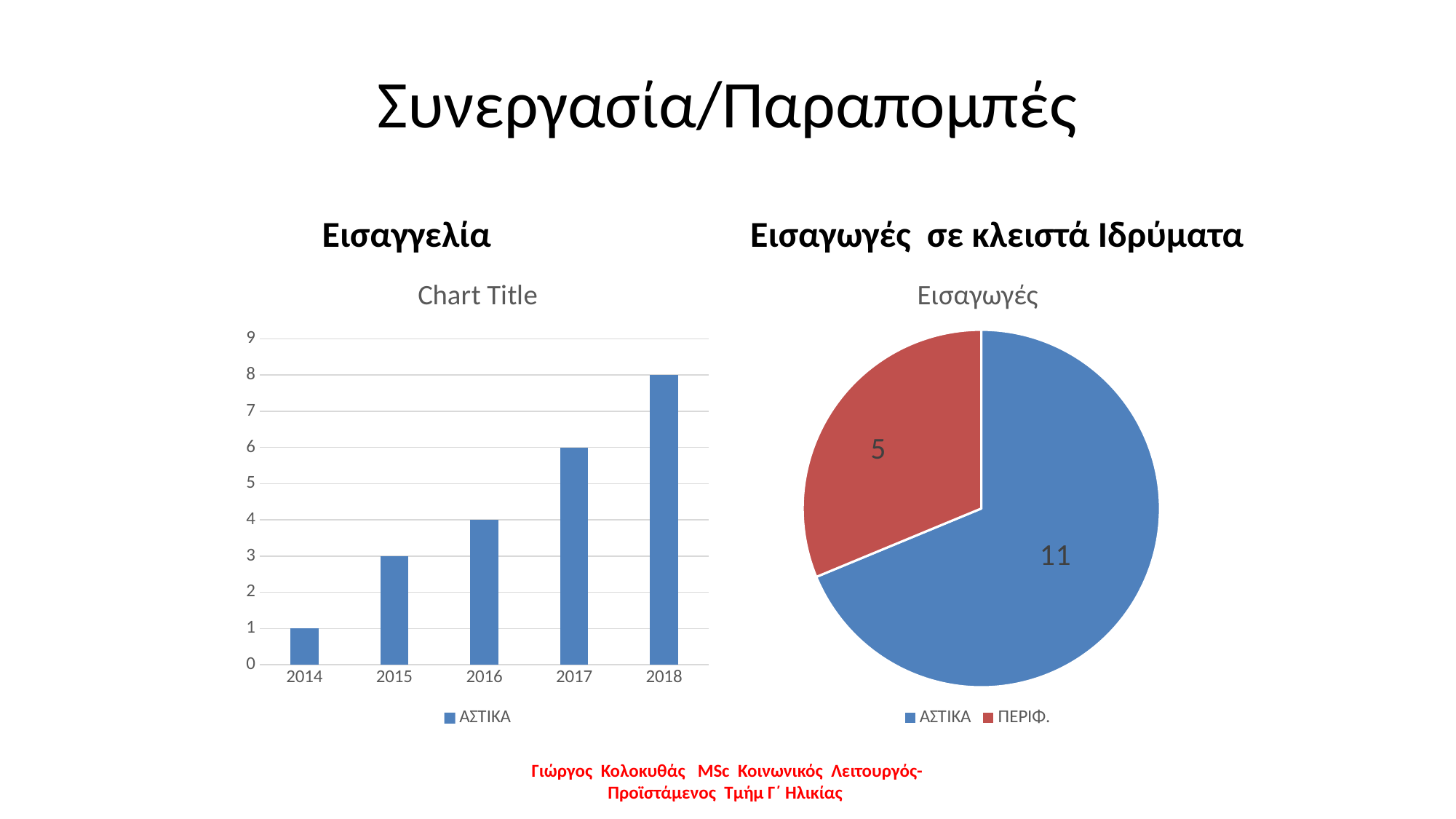
In the left bar chart (Εισαγγελία), which year has the lowest value? 2014 In the left bar chart (Εισαγγελία), do the values rise or fall from 2014 to 2018? rise In the right pie chart (Εισαγωγές), what is the value for ΠΕΡΙΦ.? 5 In the left bar chart (Εισαγγελία), which year has the highest value? 2018 In the right pie chart (Εισαγωγές), what is the total of the two slices? 16 In the left bar chart (Εισαγγελία), what is the value for 2014? 1 In the left bar chart (Εισαγγελία), what is the value for 2018? 8 How many years are shown on the x axis of the left bar chart (Εισαγγελία)? 5 In the left bar chart (Εισαγγελία), what is the difference between the values for 2017 and 2015? 3 What kind of chart is the left chart under Εισαγγελία? bar chart In the right pie chart (Εισαγωγές), which category is larger, ΑΣΤΙΚΑ or ΠΕΡΙΦ.? ΑΣΤΙΚΑ How many entries does the legend of the right pie chart (Εισαγωγές) list? 2